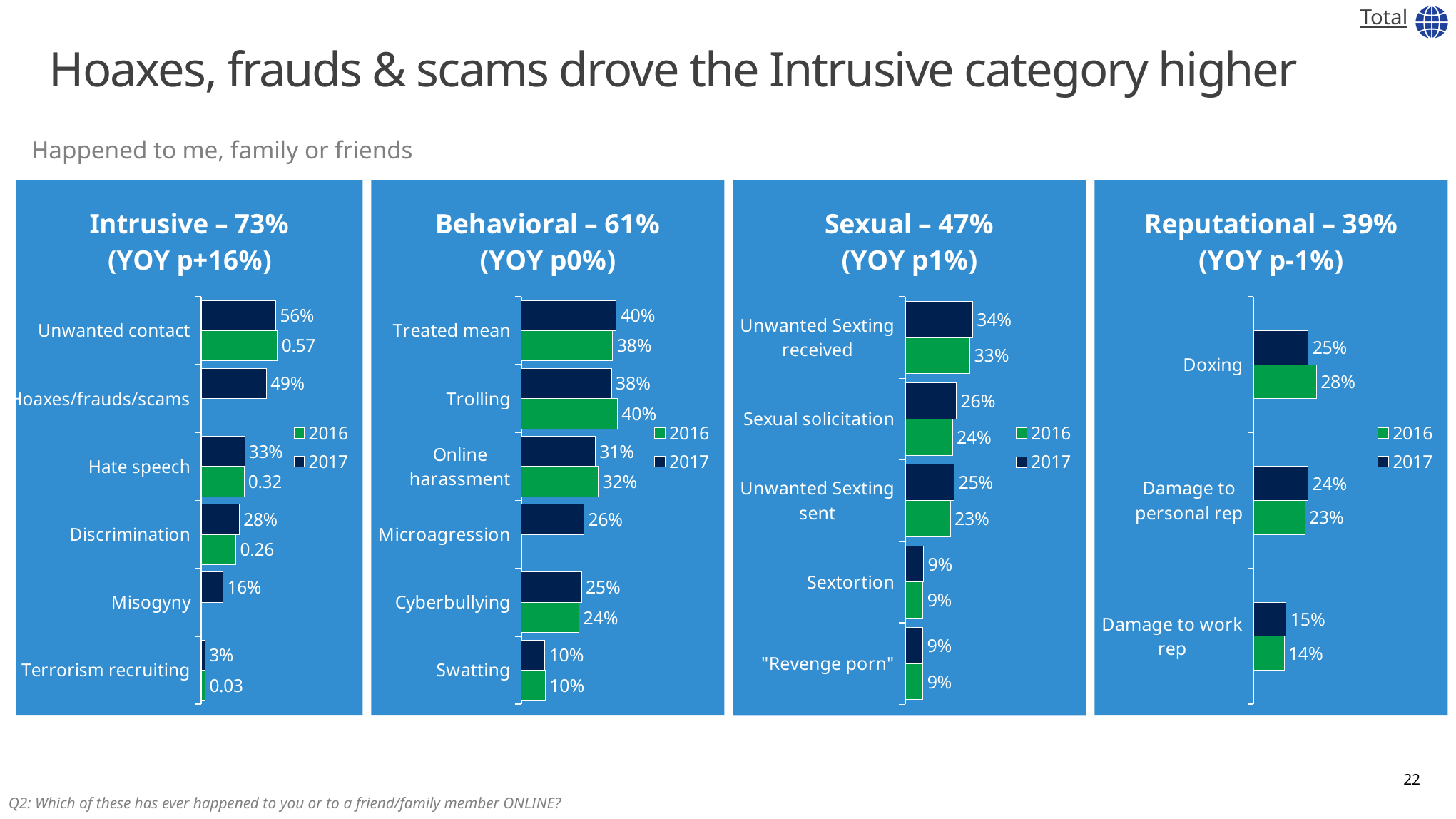
In the Sexual chart, what is the 2017 value for Sexual solicitation? 26% In the Behavioral chart, what is the difference between the 2017 values for Treated mean and Cyberbullying? 15% In the Intrusive chart, which category has the lowest 2017 value? Terrorism recruiting In the Reputational chart, which category has the highest 2016 value? Doxing In the Intrusive chart, what is the 2017 value for Hoaxes/frauds/scams? 49% What kind of chart is the Reputational chart? Bar chart In the Reputational chart, which is larger for Doxing: the 2016 value or the 2017 value? 2016 In the Intrusive chart, what is the 2016 value for Unwanted contact? 0.57 In the Behavioral chart, what is the 2016 value for Trolling? 40% How many categories are shown in the Sexual chart? 5 How many series does the legend of the Behavioral chart list? 2 What is the title of the leftmost chart? Intrusive – 73% (YOY p+16%)